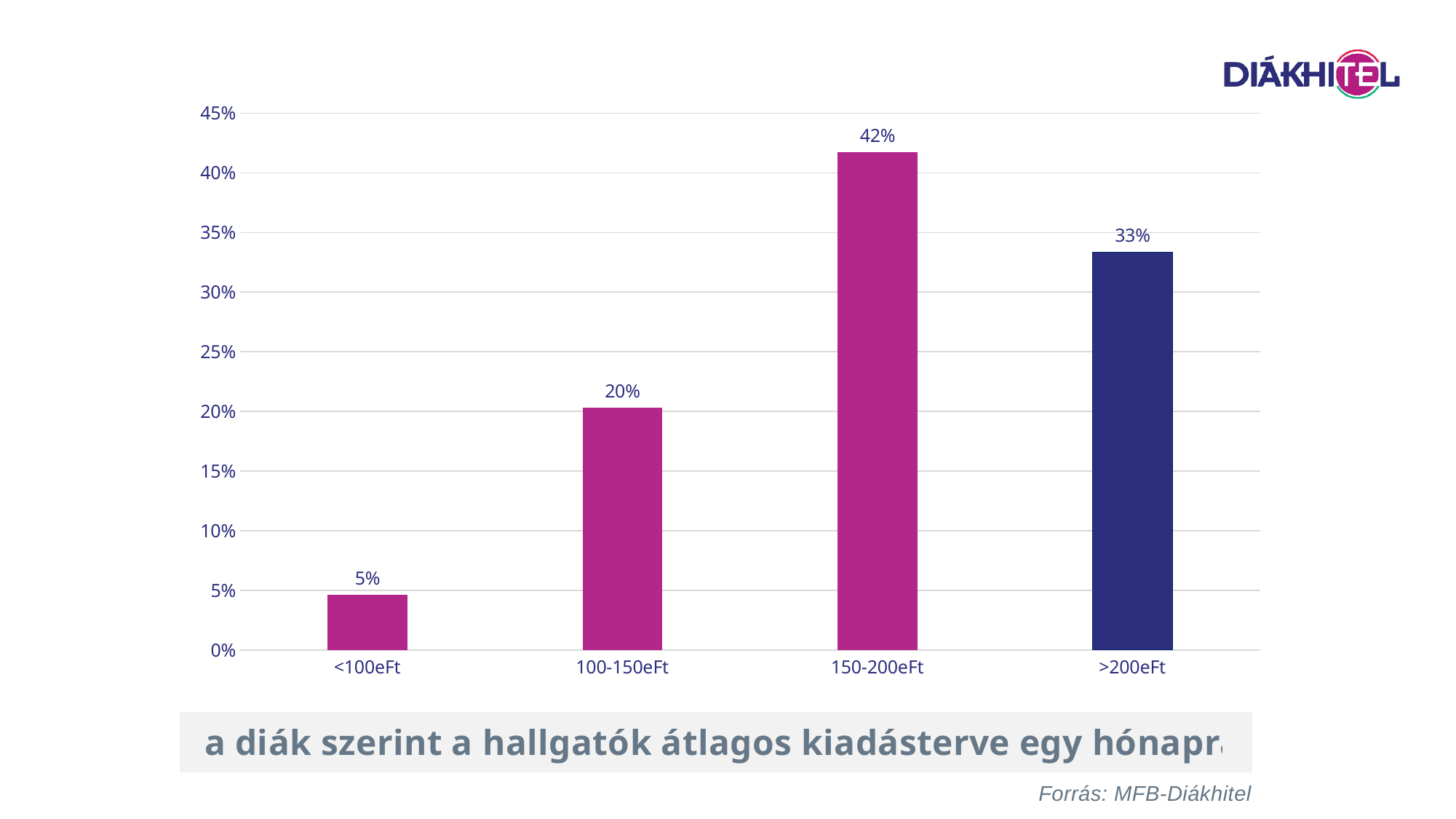
What is the value for the >200eFt category? 33% Which category's bar is coloured dark blue rather than magenta? >200eFt Which category has the lowest value? <100eFt Is the value for >200eFt greater or less than 30%? greater What is the difference between the values for 150-200eFt and >200eFt? 9% What is the value for the 150-200eFt category? 42% What is the value for the 100-150eFt category? 20% Which category has the highest value? 150-200eFt What is the value for the <100eFt category? 5% Which is larger, the value for 100-150eFt or the value for >200eFt? >200eFt What kind of chart is shown on the slide? bar chart How many categories are shown on the x axis? 4